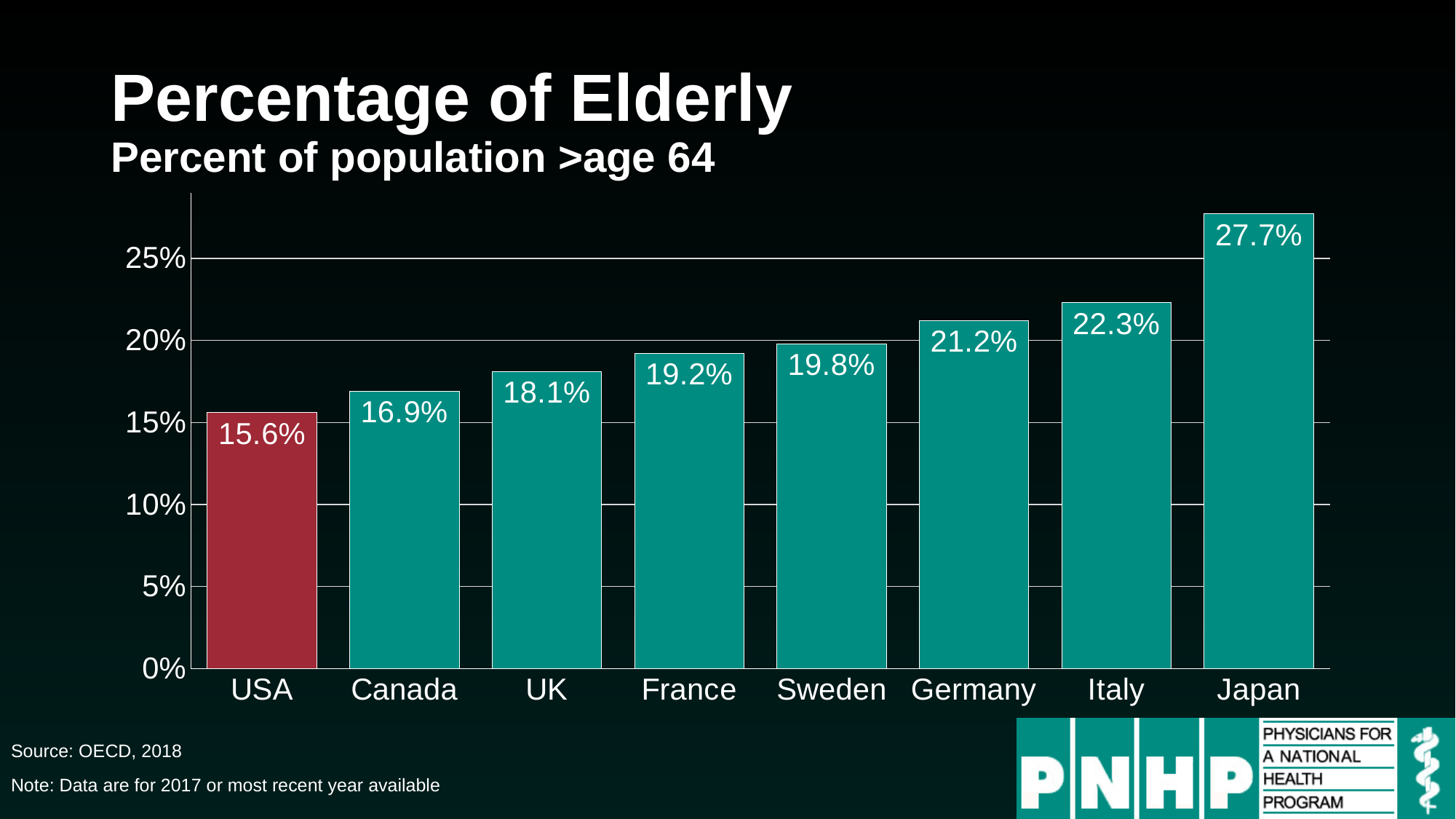
Which country has the highest percentage of elderly? Japan What is the percentage of population over age 64 for Japan? 27.7% What kind of chart is shown on the slide? Bar chart Which bar is coloured differently from the others? USA What is the value shown for the USA? 15.6% What is the difference between Italy's and Canada's values? 5.4% What is the difference between Japan's and the USA's values? 12.1% How many countries are shown in the chart? 8 What is the value shown for Germany? 21.2% Is the value for the UK greater or less than 20%? less Which country has the lowest percentage of elderly? USA Which has a higher value, Sweden or France? Sweden